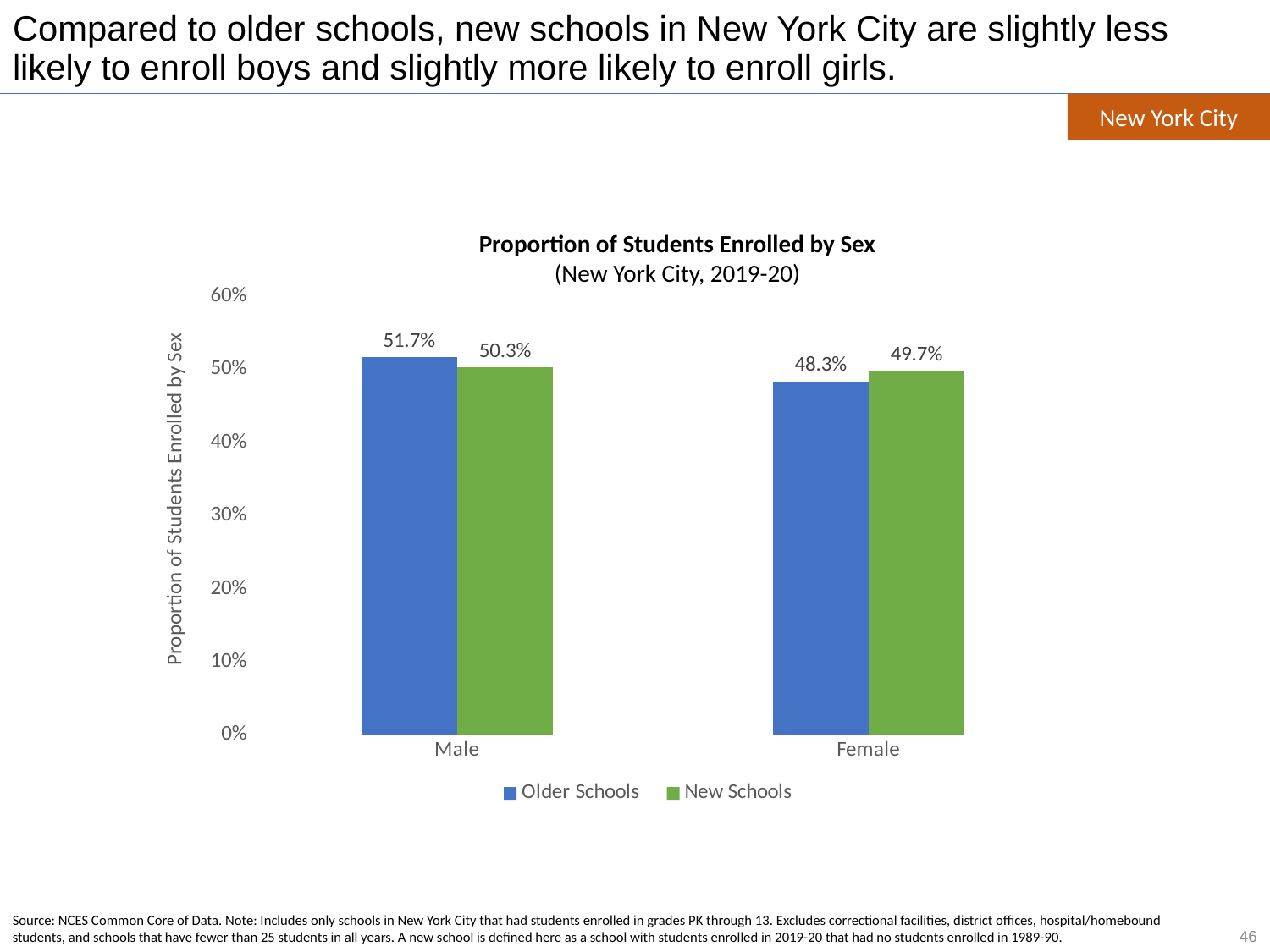
What is the value for Older Schools in the Male category? 51.7% Which bar has the lowest value on the chart? Older Schools, Female Which bar has the highest value on the chart? Older Schools, Male In the Female category, which series has the larger value, Older Schools or New Schools? New Schools How many categories are shown on the x axis? 2 What is the value for New Schools in the Male category? 50.3% What is the difference between the Older Schools and New Schools values for Male? 1.4% What is the difference between the New Schools and Older Schools values for Female? 1.4% How many series does the legend list? 2 What is the value for New Schools in the Female category? 49.7% What is the value for Older Schools in the Female category? 48.3% What kind of chart is shown on the slide? Bar chart